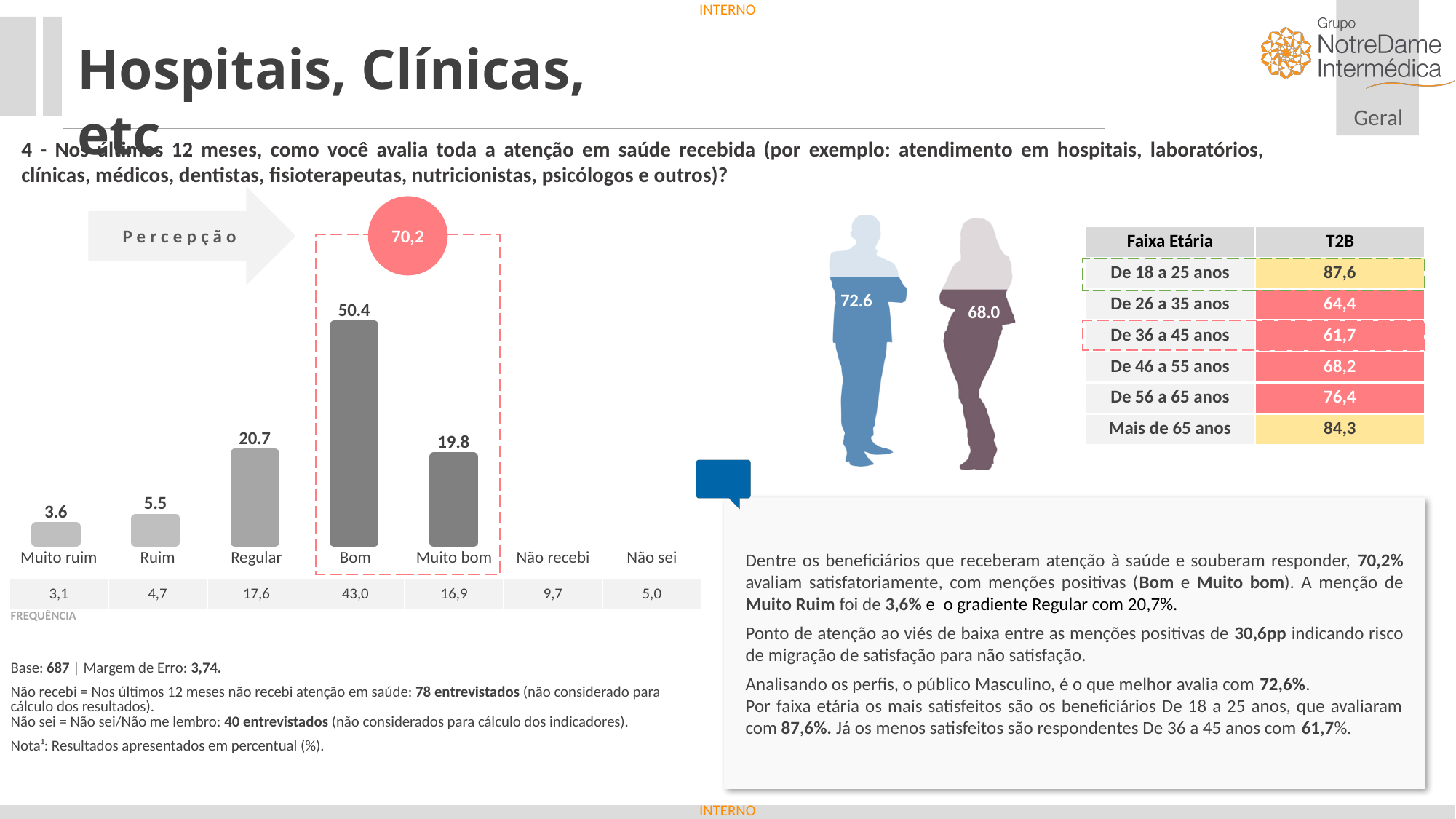
What is the value shown for the Muito ruim bar? 3.6 What is the value shown for the Muito bom bar? 19.8 What is the value shown for the Bom bar? 50.4 What value is shown in the pink circle above the Bom and Muito bom bars? 70,2 What is the value shown for the Regular bar? 20.7 Which is larger, the value for Bom or the value for Regular? Bom What is the difference between the values for Regular and Ruim? 15.2 What is the value shown for the Ruim bar? 5.5 Which category has the lowest bar in the chart? Muito ruim Which category has the highest bar in the chart? Bom What is the difference between the values for Bom and Muito bom? 30.6 What kind of chart is shown on the left of the slide? bar chart